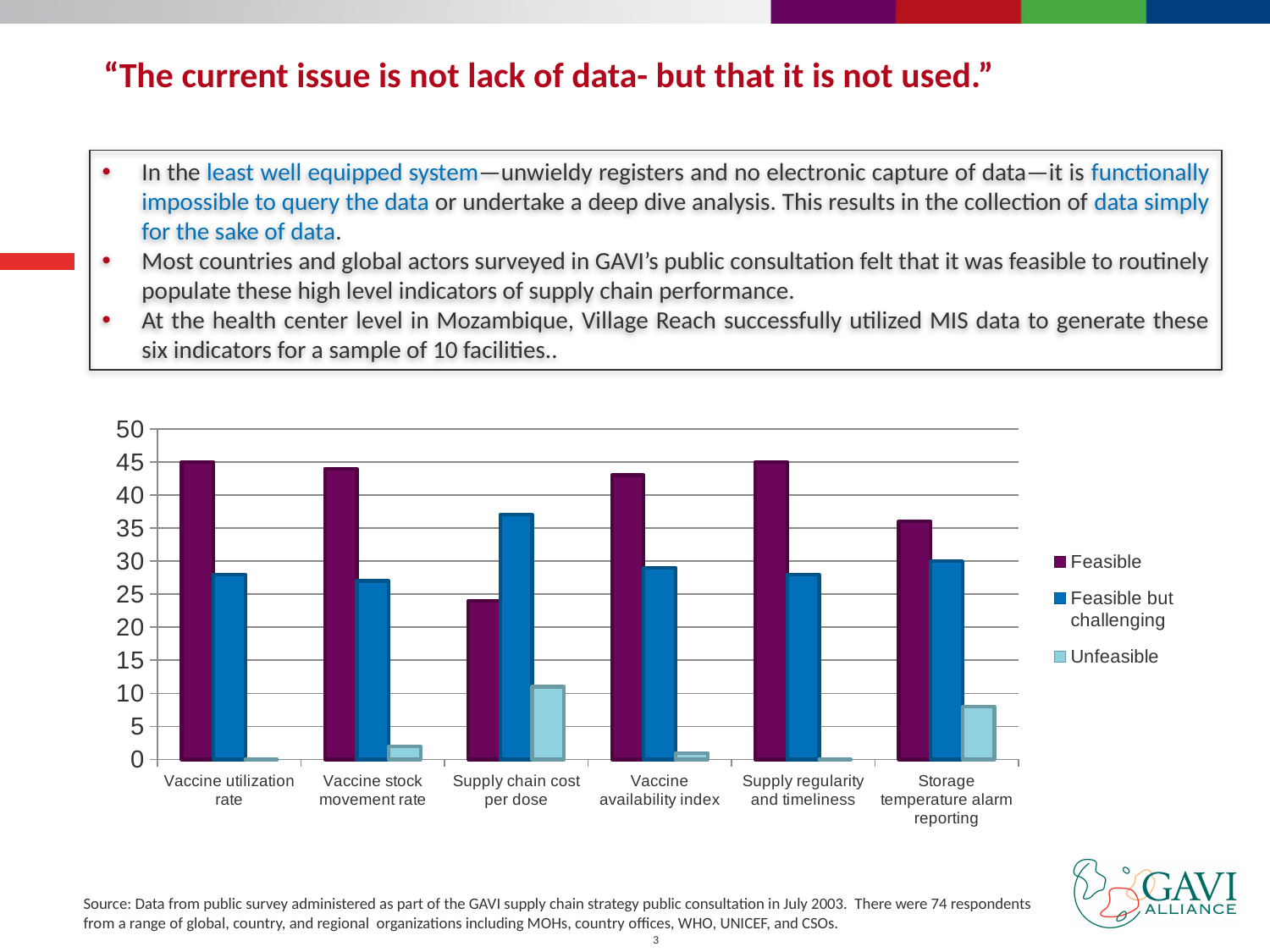
Which category has the highest value for the Unfeasible series? Supply chain cost per dose How many categories are shown on the x axis of the chart? 6 Which category has the highest value for the Feasible but challenging series? Supply chain cost per dose Which series is shown in light blue in the chart's legend? Unfeasible Which category has the lowest value for the Feasible series? Supply chain cost per dose Is the Feasible value for Supply chain cost per dose greater or less than 30? less How many series does the chart's legend list? 3 For Storage temperature alarm reporting, which is larger: the Feasible value or the Feasible but challenging value? Feasible Is the Unfeasible value for Supply chain cost per dose greater or less than 5? greater For Supply chain cost per dose, which is larger: the Feasible value or the Feasible but challenging value? Feasible but challenging Is the Feasible value for Vaccine utilization rate greater or less than 40? greater What kind of chart is shown on the slide? bar chart